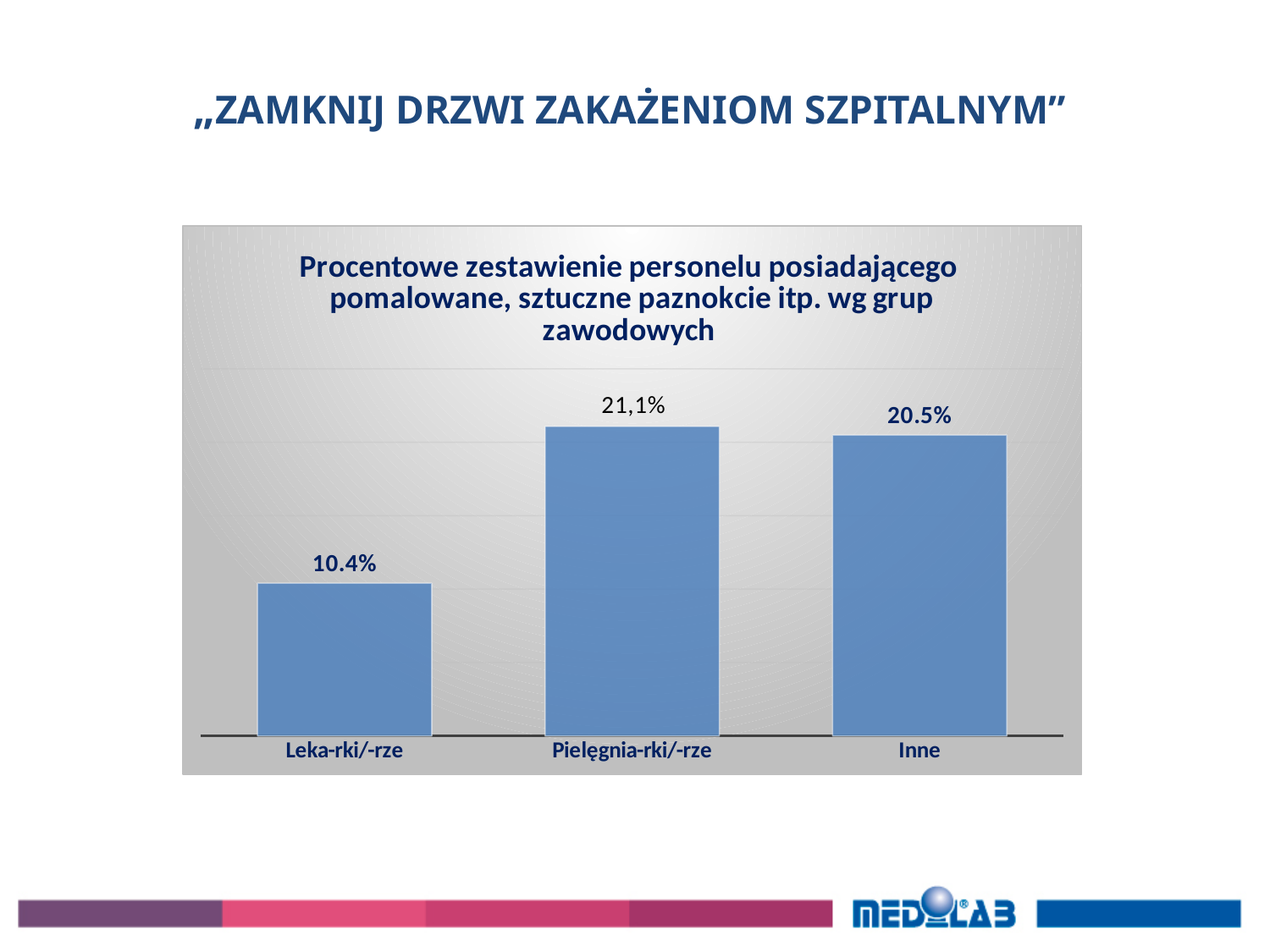
Which is larger, the value for Leka-rki/-rze or the value for Inne? Inne Which is larger, the value for Pielęgnia-rki/-rze or the value for Inne? Pielęgnia-rki/-rze What kind of chart is shown on the slide? Bar chart What is the value for Pielęgnia-rki/-rze? 21,1% What is the value for Inne? 20.5% Which professional group has the highest value? Pielęgnia-rki/-rze Which professional group has the lowest value? Leka-rki/-rze What is the difference between the values for Pielęgnia-rki/-rze and Leka-rki/-rze? 10.7% What is the value for Leka-rki/-rze? 10.4% What is the title of the chart? Procentowe zestawienie personelu posiadającego pomalowane, sztuczne paznokcie itp. wg grup zawodowych What is the difference between the values for Inne and Leka-rki/-rze? 10.1% How many professional groups are shown in the chart? 3